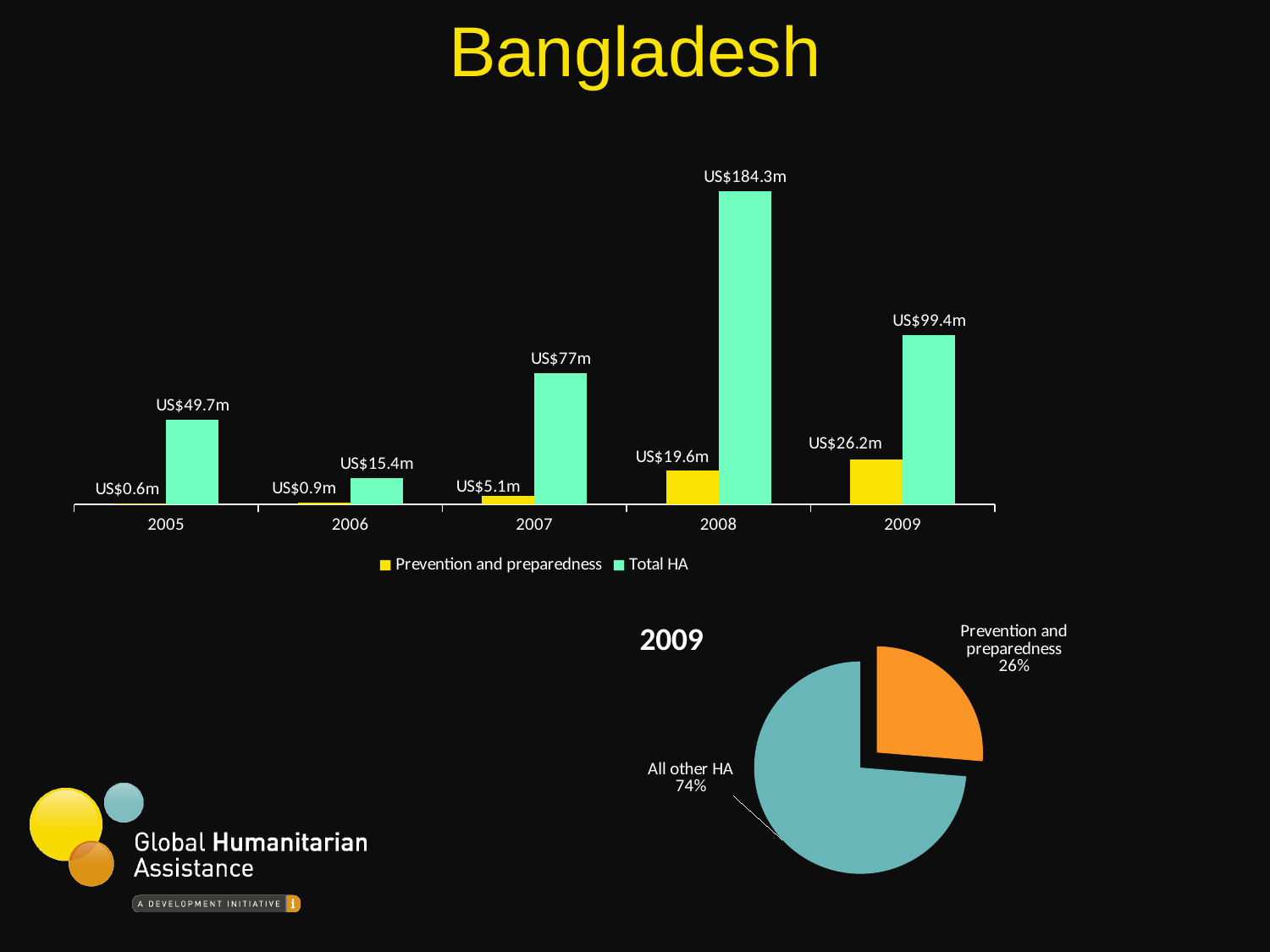
In the bar chart, what is the Total HA value for 2008? US$184.3m In the bar chart, which is larger: Total HA in 2006 or Total HA in 2005? Total HA in 2005 In the bar chart, what is the Prevention and preparedness value for 2009? US$26.2m What kind of chart is the top chart on the slide? Bar chart In the pie chart titled 2009, what share is Prevention and preparedness? 26% How many series does the legend of the bar chart list? 2 In the bar chart, what is the Prevention and preparedness value for 2005? US$0.6m In the bar chart, which year has the lowest Prevention and preparedness value? 2005 In the pie chart titled 2009, what share is All other HA? 74% In the bar chart, what is the difference between Total HA and Prevention and preparedness in 2007? US$71.9m In the bar chart, which year has the highest Total HA value? 2008 How many years are shown on the x axis of the bar chart? 5